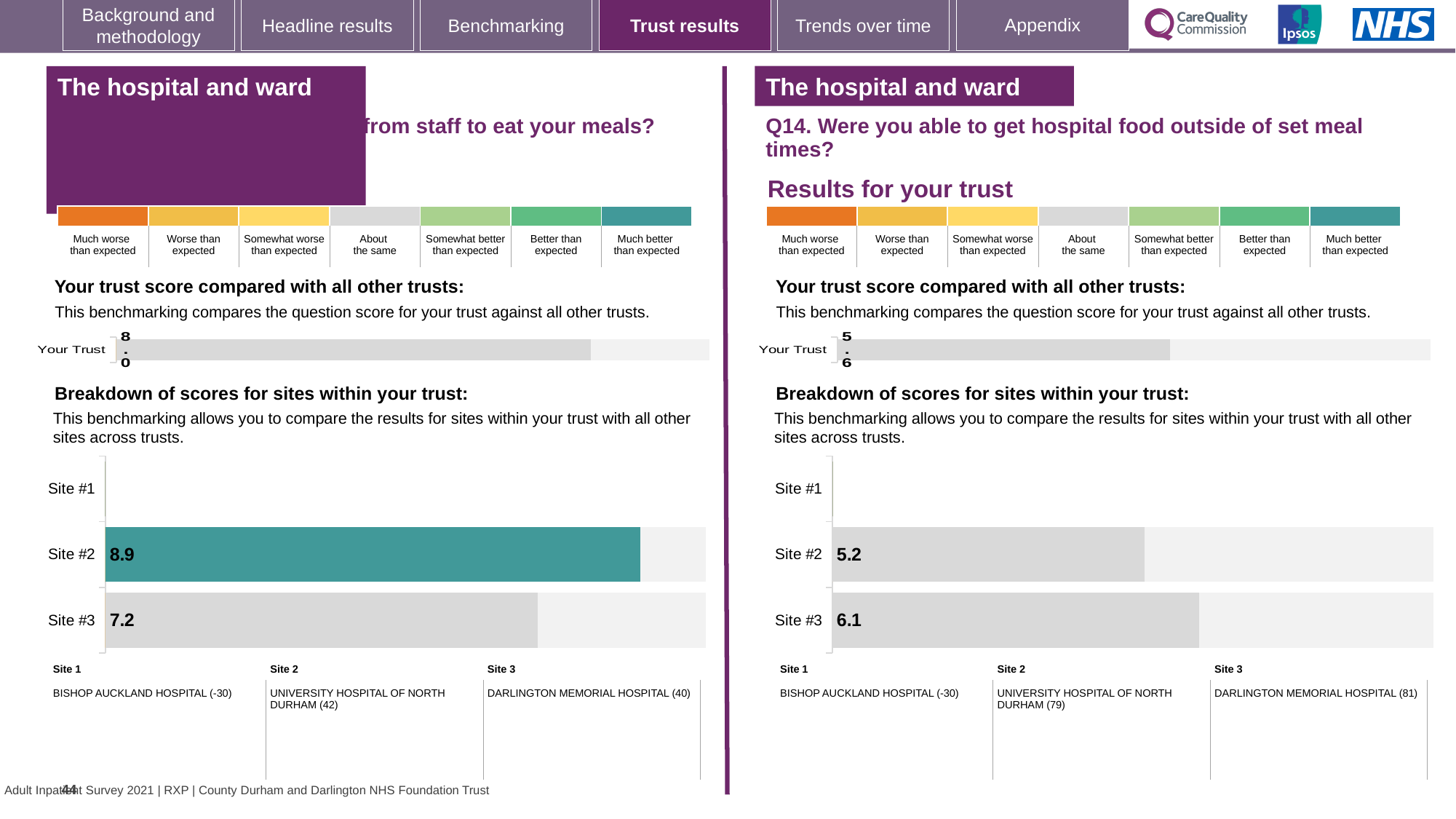
On the left-hand chart, what is the difference between the Site #2 and Site #3 scores? 1.7 On the left-hand chart, which site has the higher score, Site #2 or Site #3? Site #2 On the right-hand chart (Q14), what is the 'Your Trust' score? 5.6 On the right-hand chart (Q14), which site has the higher score, Site #2 or Site #3? Site #3 On the right-hand chart (Q14, hospital food outside of set meal times), what is the score for Site #2? 5.2 What type of chart is used to show the breakdown of scores for sites within the trust? Bar chart On the right-hand chart (Q14), what is the score for Site #3? 6.1 On the right-hand chart (Q14), what is the difference between the Site #3 and Site #2 scores? 0.9 On the left-hand chart, what is the score for Site #3? 7.2 On the right-hand chart (Q14), which hospital is listed as Site 3? DARLINGTON MEMORIAL HOSPITAL (81) On the left-hand chart, what is the 'Your Trust' score? 8.0 On the left-hand chart (question about help from staff to eat your meals), what is the score for Site #2? 8.9